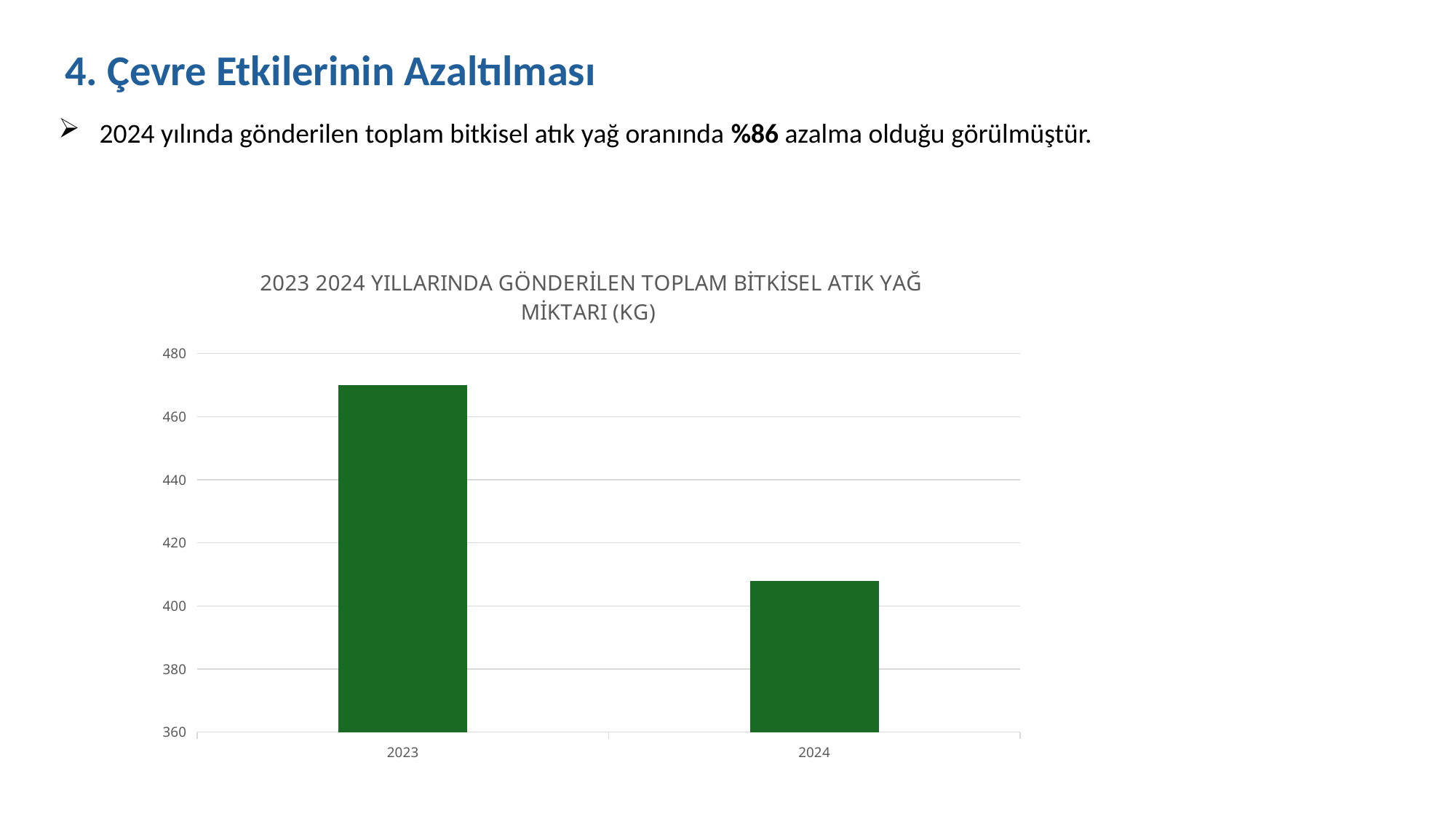
What is the title of the chart? 2023 2024 YILLARINDA GÖNDERİLEN TOPLAM BİTKİSEL ATIK YAĞ MİKTARI (KG) What colour are the bars in the chart? green Which year has the lowest total vegetable waste oil amount? 2024 Which is larger, the value for 2023 or the value for 2024? 2023 Is the value for 2024 greater or less than 400? greater How many bars (categories) does the chart show? 2 Is the value for 2023 greater or less than 460? greater Which year has the highest total vegetable waste oil amount? 2023 Is the value for 2023 greater or less than 480? less What kind of chart is shown on the slide? bar chart Do the values rise or fall from 2023 to 2024? fall